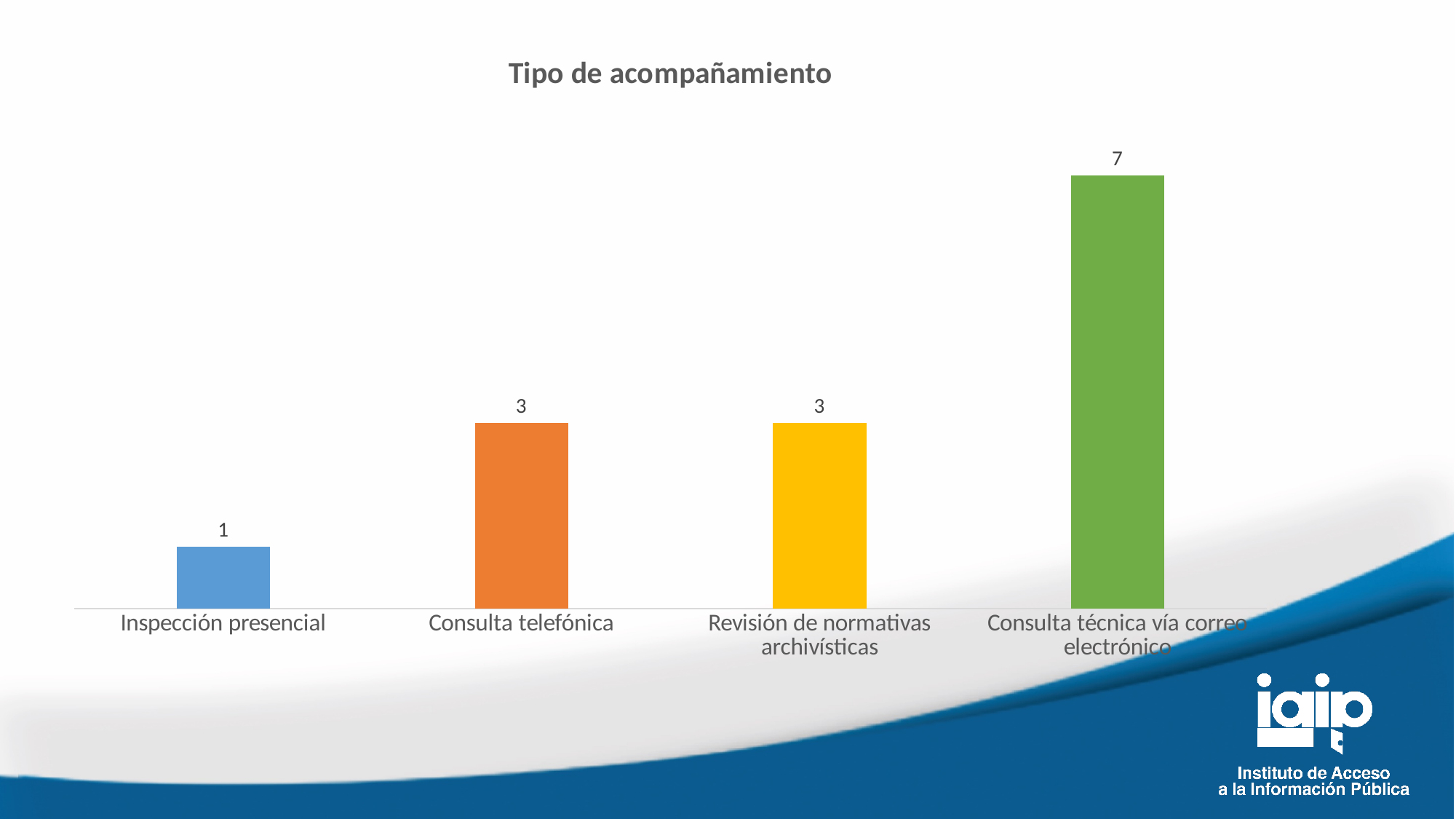
What is the value for Consulta técnica vía correo electrónico? 7 What is the title of the chart? Tipo de acompañamiento What is the difference between the values for Consulta técnica vía correo electrónico and Consulta telefónica? 4 What is the value for Consulta telefónica? 3 What is the value for Inspección presencial? 1 Which is larger, the value for Consulta técnica vía correo electrónico or the value for Revisión de normativas archivísticas? Consulta técnica vía correo electrónico How many categories are shown in the chart? 4 What kind of chart is shown on the slide? Bar chart What is the value for Revisión de normativas archivísticas? 3 Which category has the lowest value? Inspección presencial What is the difference between the values for Consulta telefónica and Inspección presencial? 2 Which category has the highest value? Consulta técnica vía correo electrónico